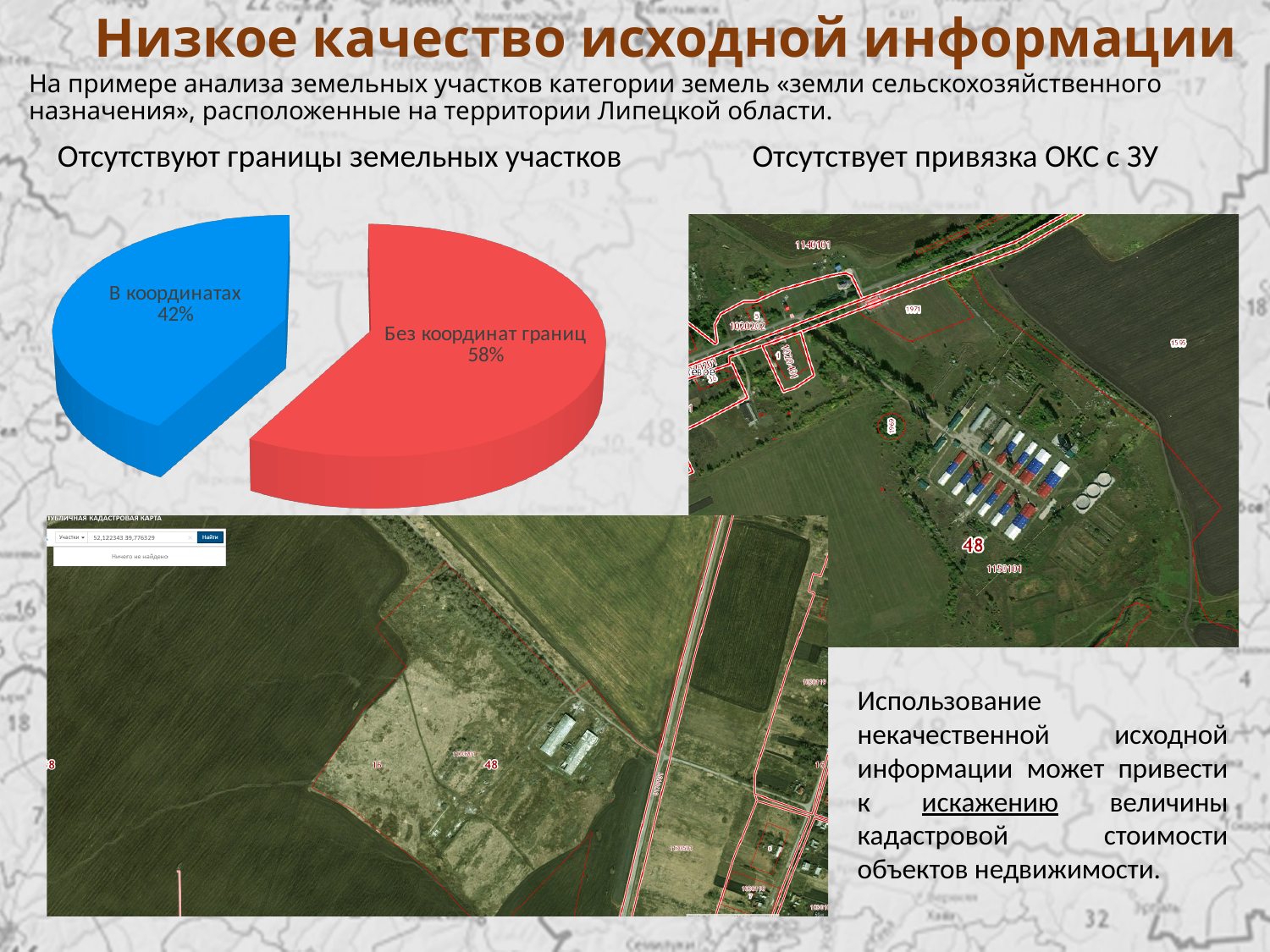
What colour is the «В координатах» slice of the pie chart? Blue Which is larger in the pie chart: «В координатах» or «Без координат границ»? Без координат границ What share of the pie chart is labelled «В координатах»? 42% Which slice of the pie chart is the largest? Без координат границ What type of chart is shown on the slide? Pie chart What colour is the «Без координат границ» slice of the pie chart? Red Which slice of the pie chart is the smallest? В координатах What is the difference in percentage points between the «Без координат границ» slice and the «В координатах» slice? 16 Is the share for «В координатах» greater or less than 50%? less How many slices does the pie chart have? 2 What share of the pie chart is labelled «Без координат границ»? 58%